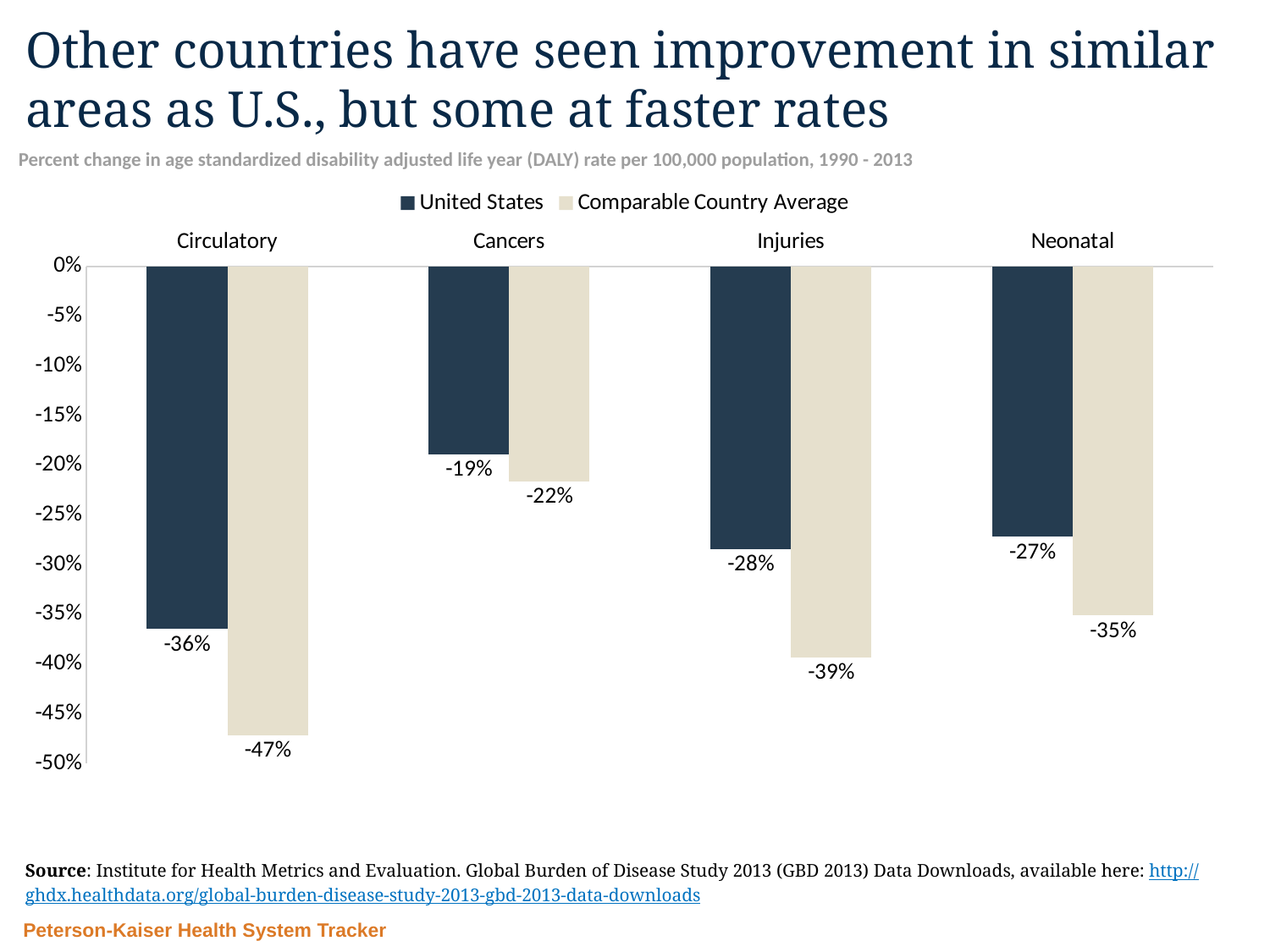
How many series does the legend list? 2 How many categories are shown on the x axis? 4 Which category has the highest (least negative) United States value? Cancers Which is more negative for Injuries: the United States value or the Comparable Country Average value? Comparable Country Average Which category has the lowest (most negative) Comparable Country Average value? Circulatory What is the value for the United States in the Circulatory category? -36% What is the Comparable Country Average value for Neonatal? -35% What is the difference between the United States and Comparable Country Average values for Cancers? 3 percentage points What is the United States value for Cancers? -19% What kind of chart is shown on the slide? Bar chart What is the Comparable Country Average value for Injuries? -39% What is the difference between the Comparable Country Average and United States values for Circulatory? 11 percentage points